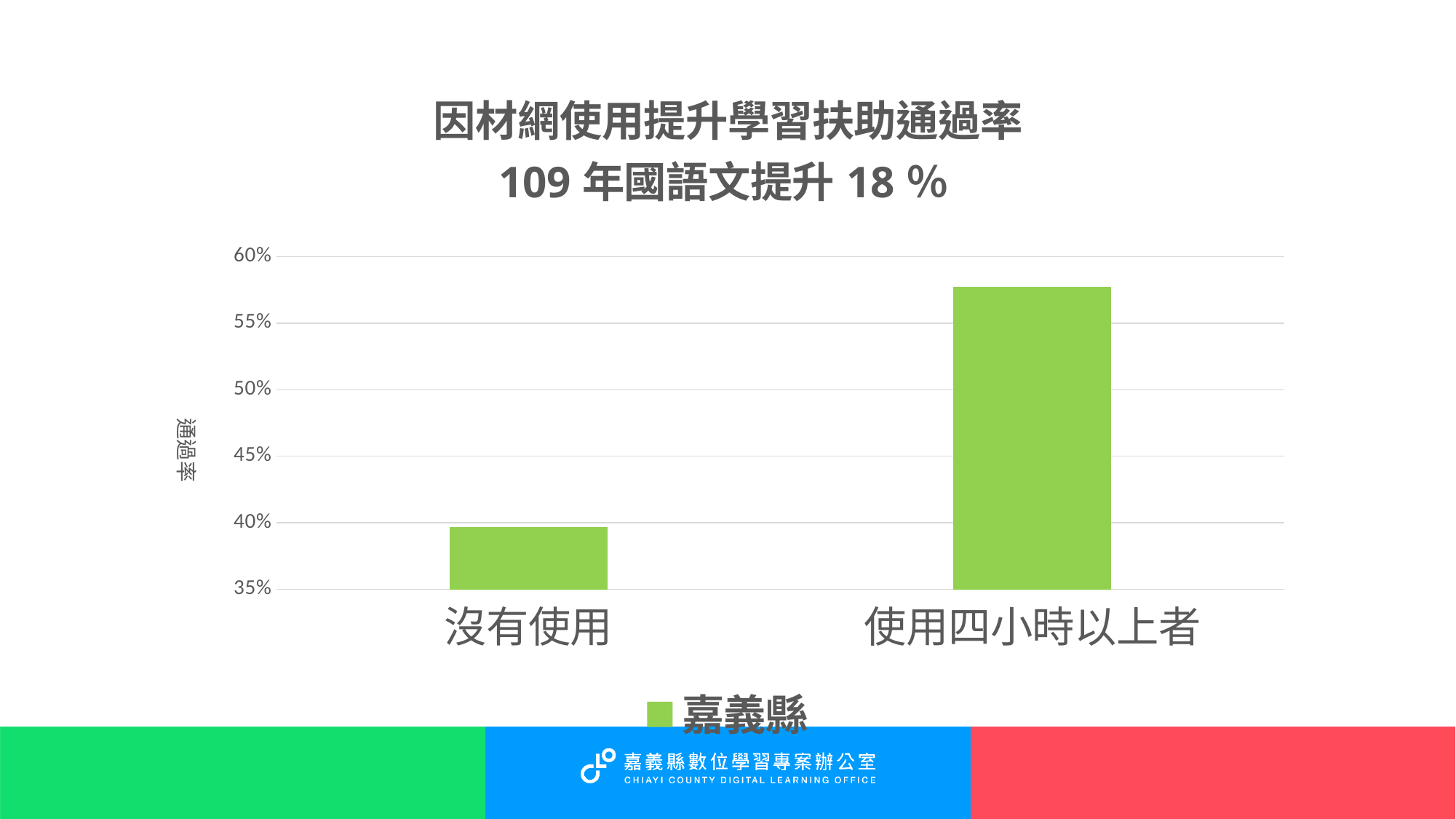
How many categories are plotted on the x axis? 2 What series name is shown in the legend? 嘉義縣 What kind of chart is shown on the slide? bar chart Do the values rise or fall from left to right along the x axis? rise Which is larger, the value for 沒有使用 or the value for 使用四小時以上者? 使用四小時以上者 Is the value for 使用四小時以上者 greater or less than 60%? less Which category has the lowest pass rate (通過率)? 沒有使用 Which category has the highest pass rate (通過率)? 使用四小時以上者 What is the label of the vertical axis? 通過率 How many series does the legend list? 1 Is the value for 使用四小時以上者 greater or less than 55%? greater